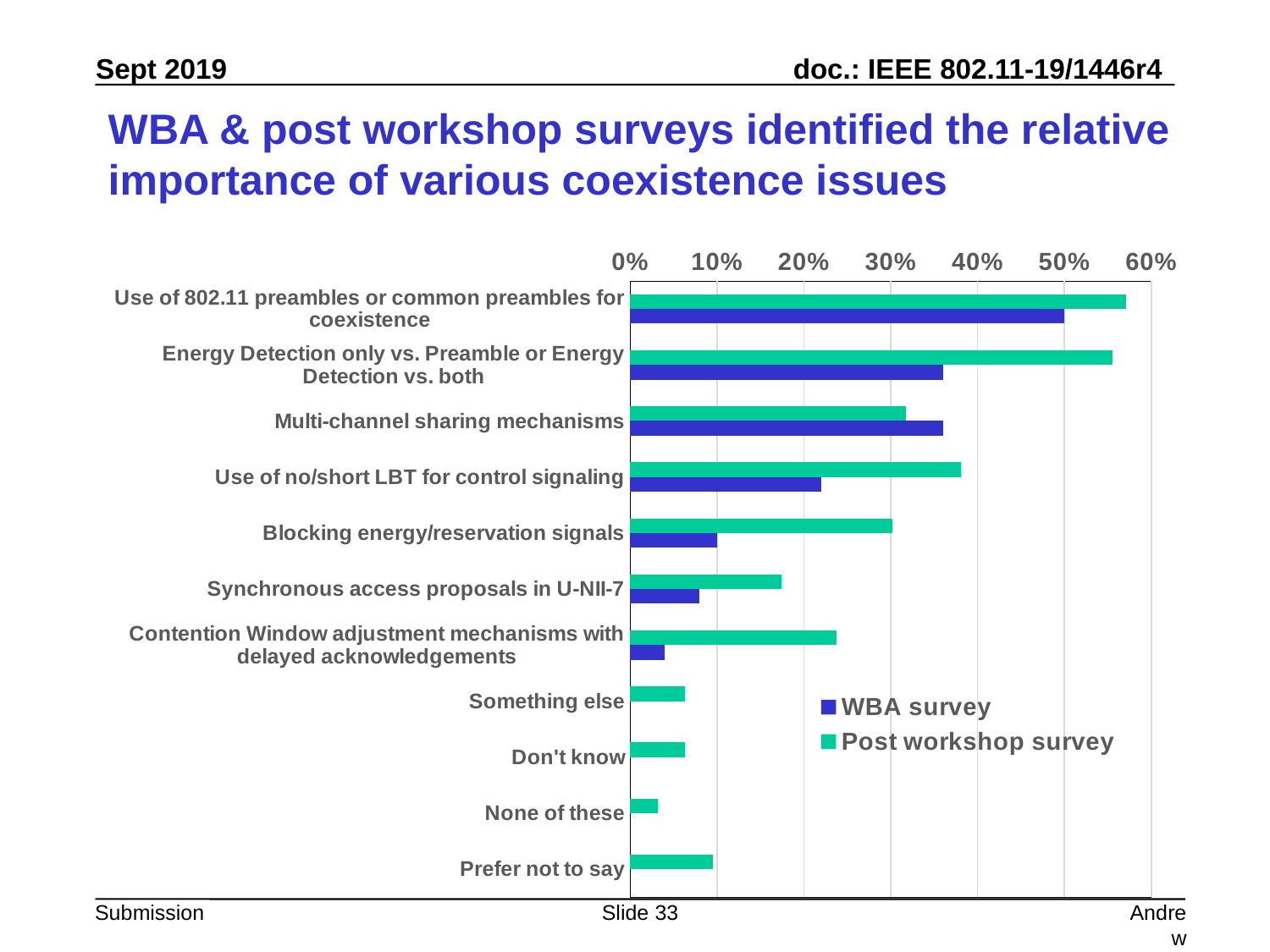
How many series does the legend list? 2 How many categories have a WBA survey bar plotted? 7 For Use of no/short LBT for control signaling, which series has the larger value, WBA survey or Post workshop survey? Post workshop survey Is the Post workshop survey value for Contention Window adjustment mechanisms with delayed acknowledgements greater or less than 20%? greater Is the WBA survey value for Blocking energy/reservation signals greater or less than 20%? less What colour represents the WBA survey series in the legend? Blue How many categories are plotted on the chart? 11 What kind of chart is shown on the slide? Bar chart Is the Post workshop survey value for Blocking energy/reservation signals greater or less than 20%? greater For Multi-channel sharing mechanisms, which series has the larger value, WBA survey or Post workshop survey? WBA survey Which category has the lowest value for the Post workshop survey? None of these Which category has the highest value for the WBA survey? Use of 802.11 preambles or common preambles for coexistence